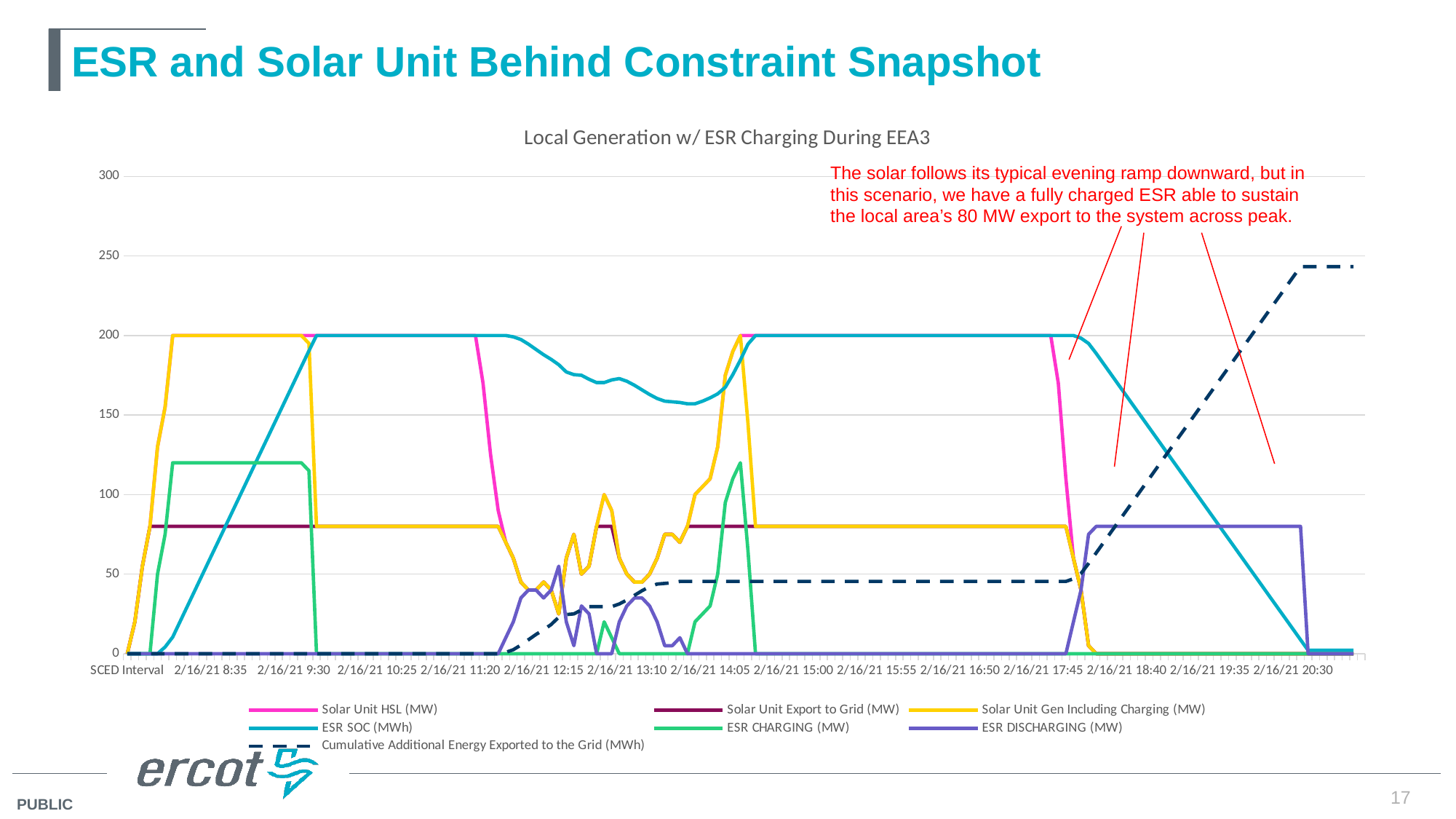
Is the value of ESR DISCHARGING (MW) at 2/16/21 19:35 greater or less than 100? less How many series does the legend list? 7 Is the value of Cumulative Additional Energy Exported to the Grid (MWh) at 2/16/21 20:30 greater or less than 200? greater Which series is drawn as a dashed line? Cumulative Additional Energy Exported to the Grid (MWh) Is the value of ESR CHARGING (MW) at 2/16/21 8:35 greater or less than 100? greater At 2/16/21 18:40, which is larger: ESR SOC (MWh) or ESR DISCHARGING (MW)? ESR SOC (MWh) What kind of chart is shown on the slide? line chart What is the value of Solar Unit HSL (MW) at 2/16/21 10:25? 200 What is the title of the chart? Local Generation w/ ESR Charging During EEA3 Does ESR SOC (MWh) rise or fall between 2/16/21 17:45 and 2/16/21 20:30? fall Does Cumulative Additional Energy Exported to the Grid (MWh) rise or fall between 2/16/21 17:45 and 2/16/21 20:30? rise What is the value of ESR SOC (MWh) at 2/16/21 15:00? 200